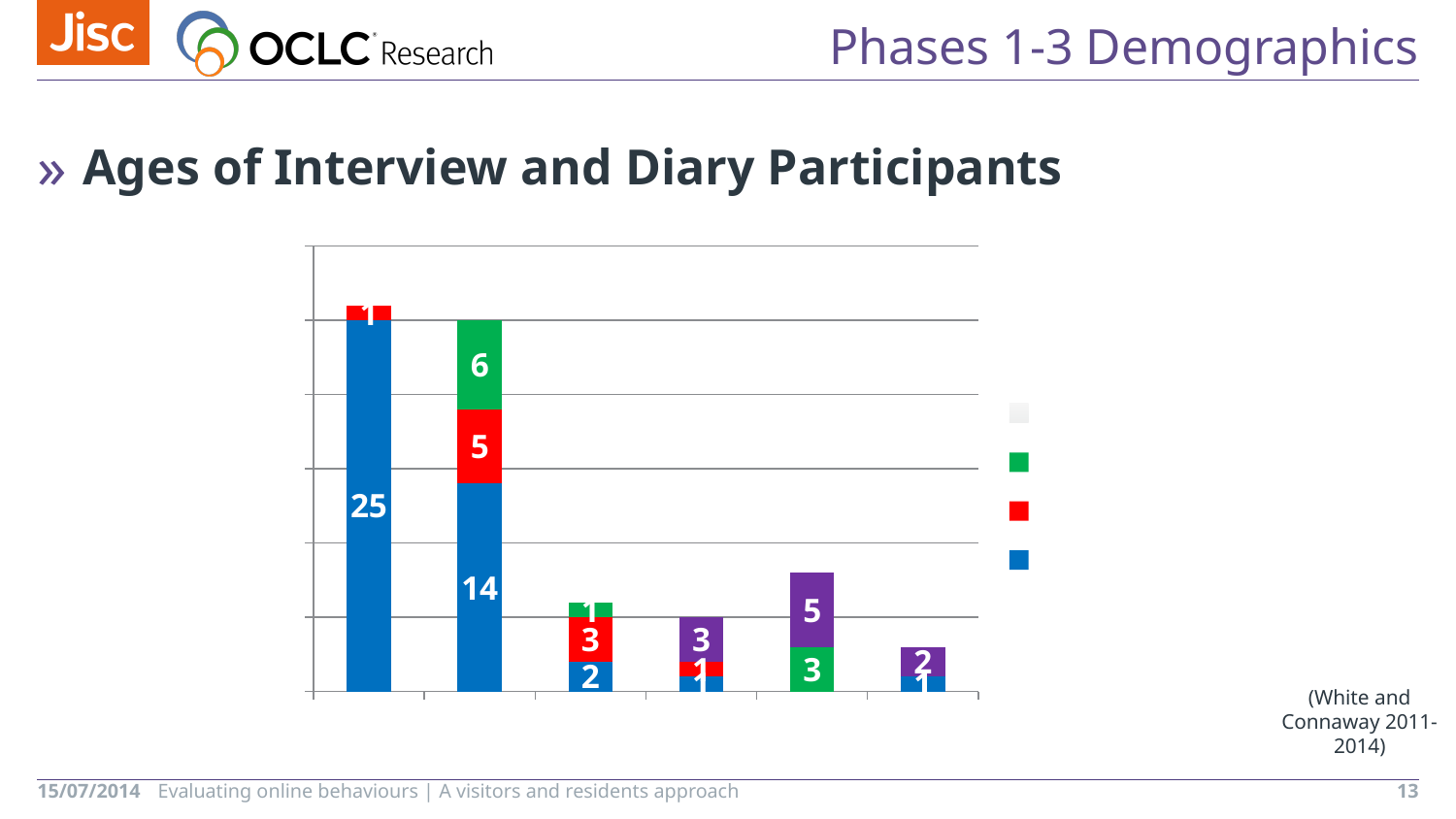
What kind of chart is shown on the slide? Stacked bar chart What is the value of the red segment in the second bar? 5 Which bar is the tallest overall? The first (leftmost) bar What is the difference between the blue segment of the first bar and the blue segment of the second bar? 11 What is the value of the blue segment in the first (leftmost) bar? 25 What is the total of the fifth stacked bar? 8 What is the total of the second stacked bar? 25 What is the value of the purple segment in the fifth bar? 5 What is the value of the green segment in the second bar? 6 What is the total of the first (leftmost) stacked bar? 26 How many colour entries does the legend show? 4 How many bars are plotted in the chart? 6